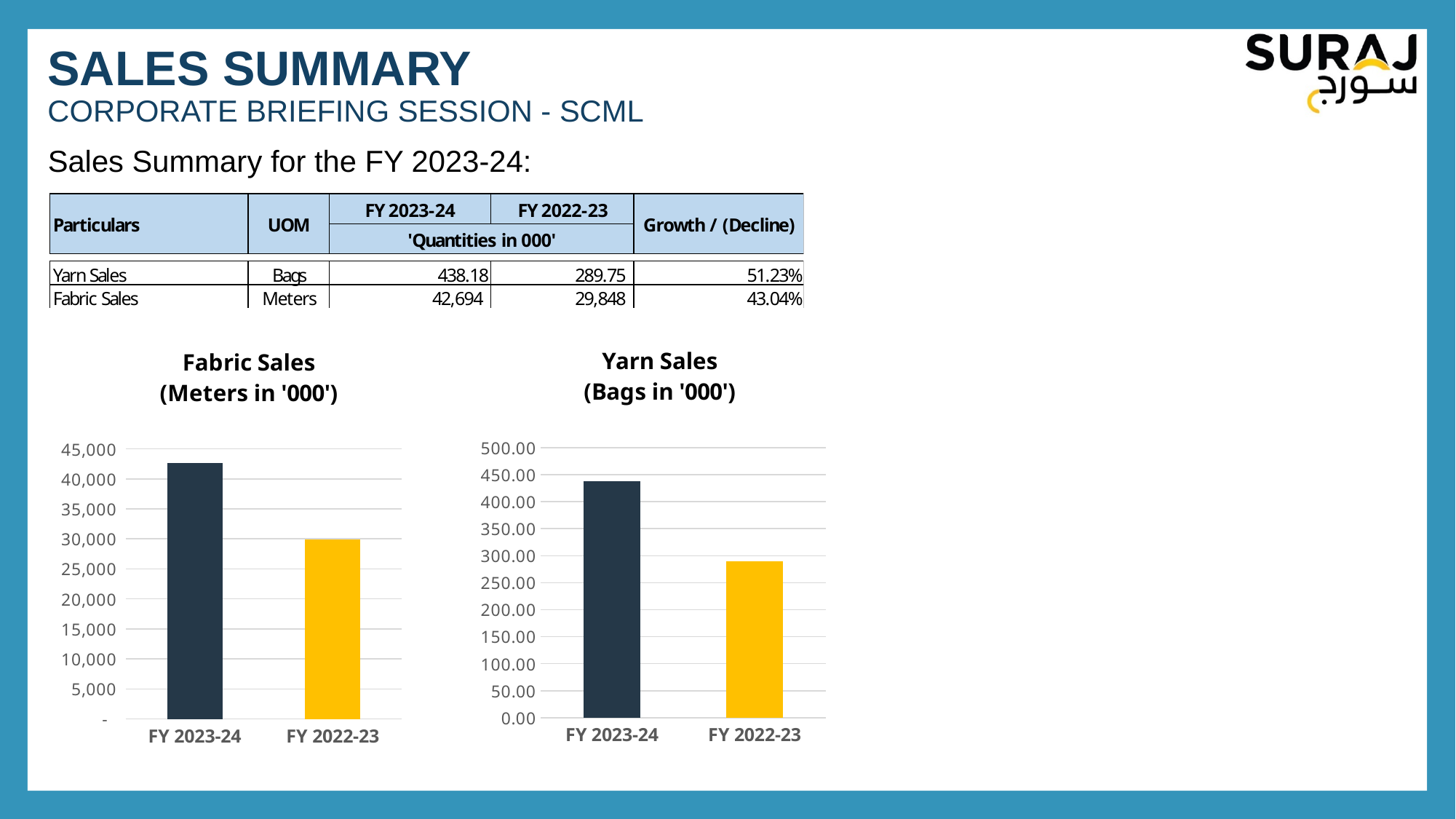
In the Yarn Sales chart, is the bar for FY 2023-24 larger or smaller than the bar for FY 2022-23? larger In the Yarn Sales chart, how many categories are shown on the x axis? 2 What unit is given in the title of the Yarn Sales chart? Bags in '000' What kind of chart is the Fabric Sales chart? bar chart In the Yarn Sales chart, which fiscal year has the lowest bar? FY 2022-23 In the Yarn Sales chart, is the value for FY 2022-23 greater or less than 300.00? less In the Fabric Sales chart, is the value for FY 2022-23 greater or less than 30,000? less In the Yarn Sales chart, is the value for FY 2023-24 greater or less than 400.00? greater In the Fabric Sales chart, which fiscal year has the higher bar? FY 2023-24 In the Fabric Sales chart, how many bars are plotted? 2 What kind of chart is the Yarn Sales chart? bar chart